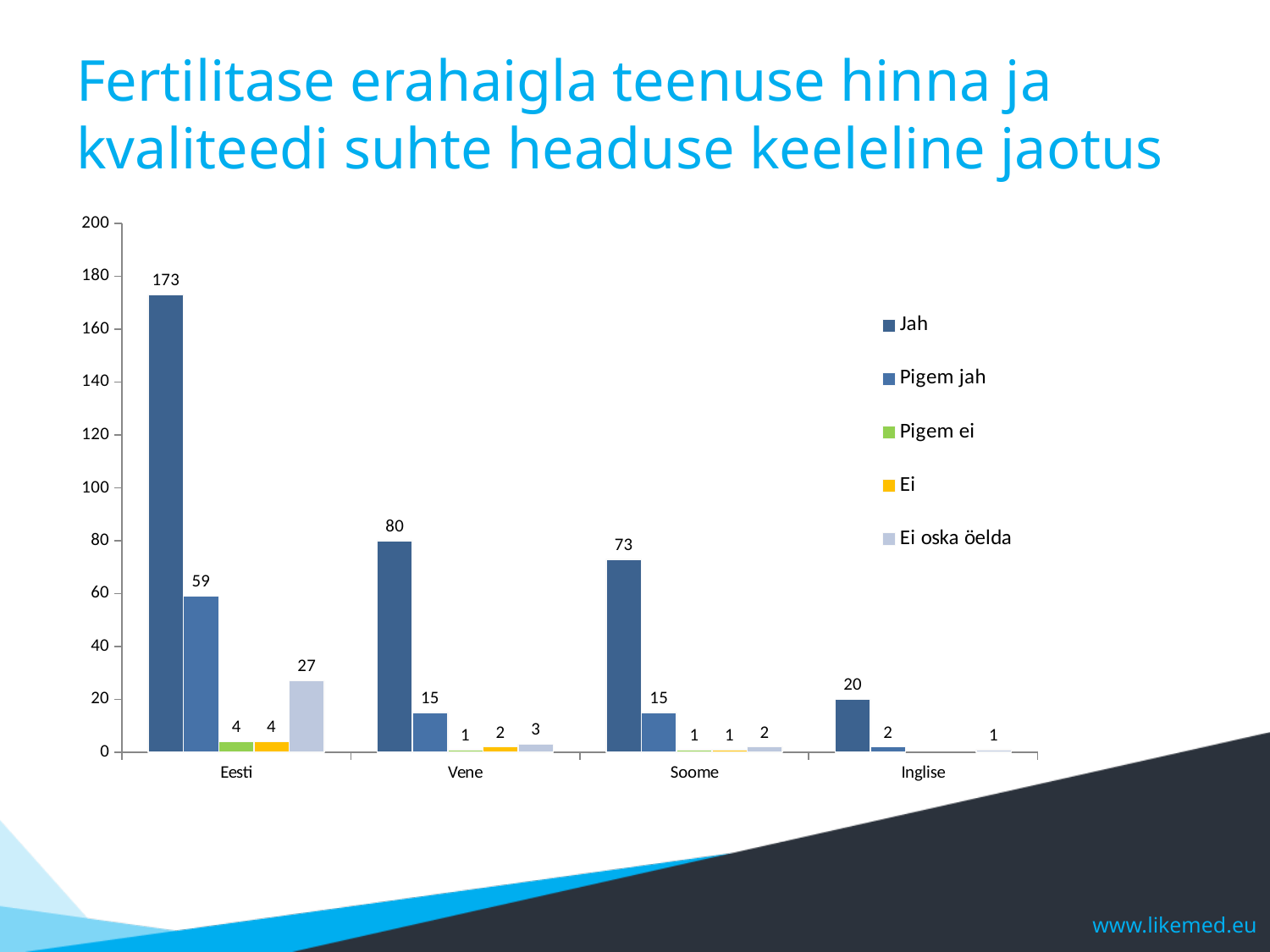
What is the value for Pigem jah in the Vene category? 15 How many categories are shown on the x axis? 4 What is the difference between the Jah and Pigem jah values for Eesti? 114 What is the value for Jah in the Inglise category? 20 Which category has the lowest value for Jah? Inglise What is the difference between the Jah values for Vene and Soome? 7 What is the value for Jah in the Eesti category? 173 Which category has the highest value for Jah? Eesti What is the value for Ei oska öelda in the Eesti category? 27 Which is larger: the Pigem jah value for Eesti or the Jah value for Vene? Jah value for Vene How many series does the legend list? 5 What kind of chart is shown on the slide? Bar chart